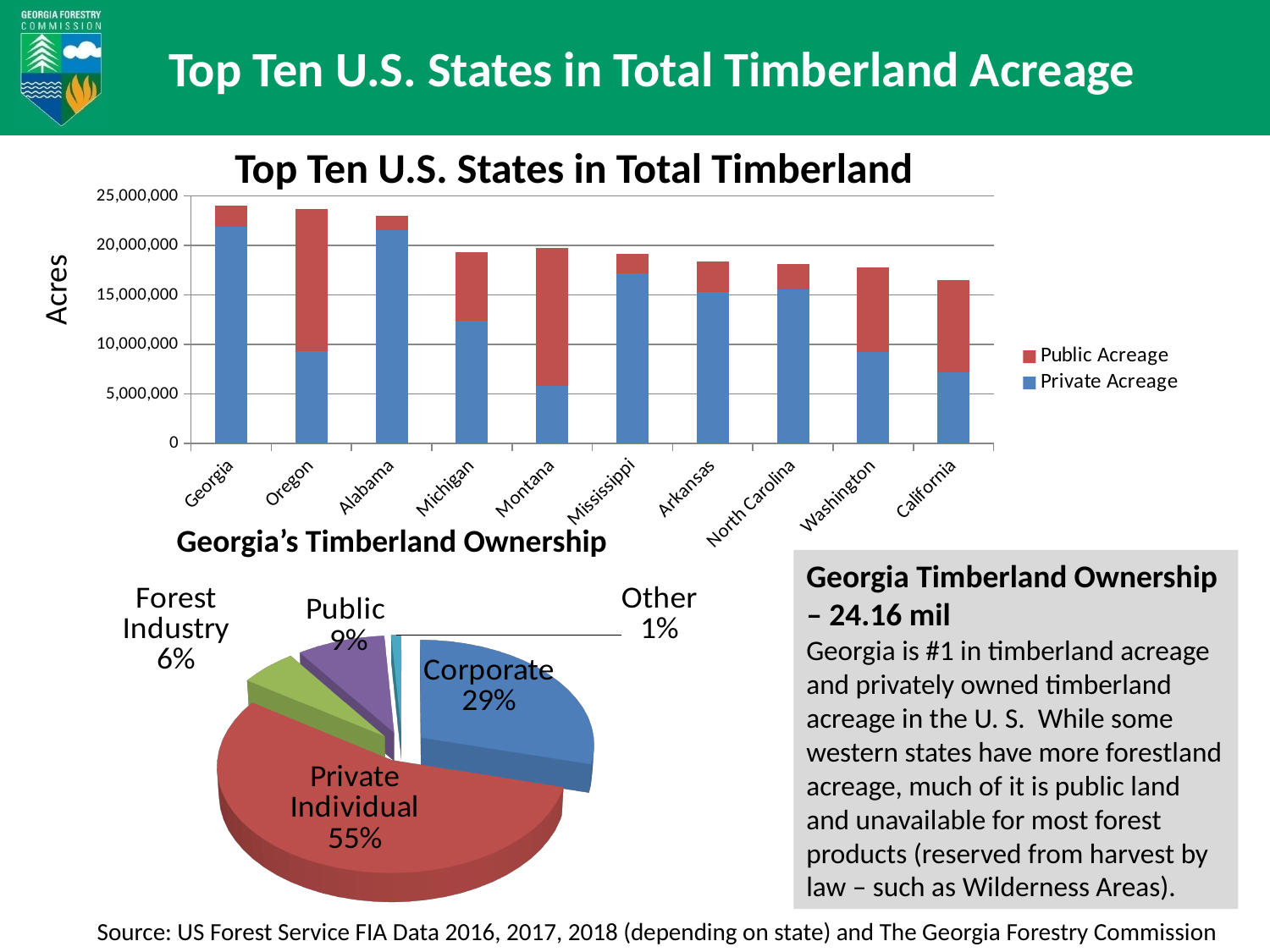
In the pie chart "Georgia's Timberland Ownership", what share is Private Individual? 55% In the pie chart "Georgia's Timberland Ownership", how many percentage points larger is Private Individual than Corporate? 26 In the pie chart "Georgia's Timberland Ownership", which category has the smallest share? Other In the top chart "Top Ten U.S. States in Total Timberland", how many series does the legend list? 2 In the top chart "Top Ten U.S. States in Total Timberland", is the total acreage for Georgia greater or less than 20,000,000? greater In the top chart "Top Ten U.S. States in Total Timberland", is the Private Acreage for Montana greater or less than 10,000,000? less In the top chart "Top Ten U.S. States in Total Timberland", how many states are shown on the x axis? 10 In the top chart "Top Ten U.S. States in Total Timberland", which state has the highest total timberland acreage? Georgia In the top chart "Top Ten U.S. States in Total Timberland", which state has the lowest total timberland acreage? California What kind of chart is the top chart titled "Top Ten U.S. States in Total Timberland"? Bar chart In the top chart "Top Ten U.S. States in Total Timberland", do the total bar heights generally rise or fall from left to right? Fall In the top chart "Top Ten U.S. States in Total Timberland", which state has more Private Acreage, Oregon or Alabama? Alabama